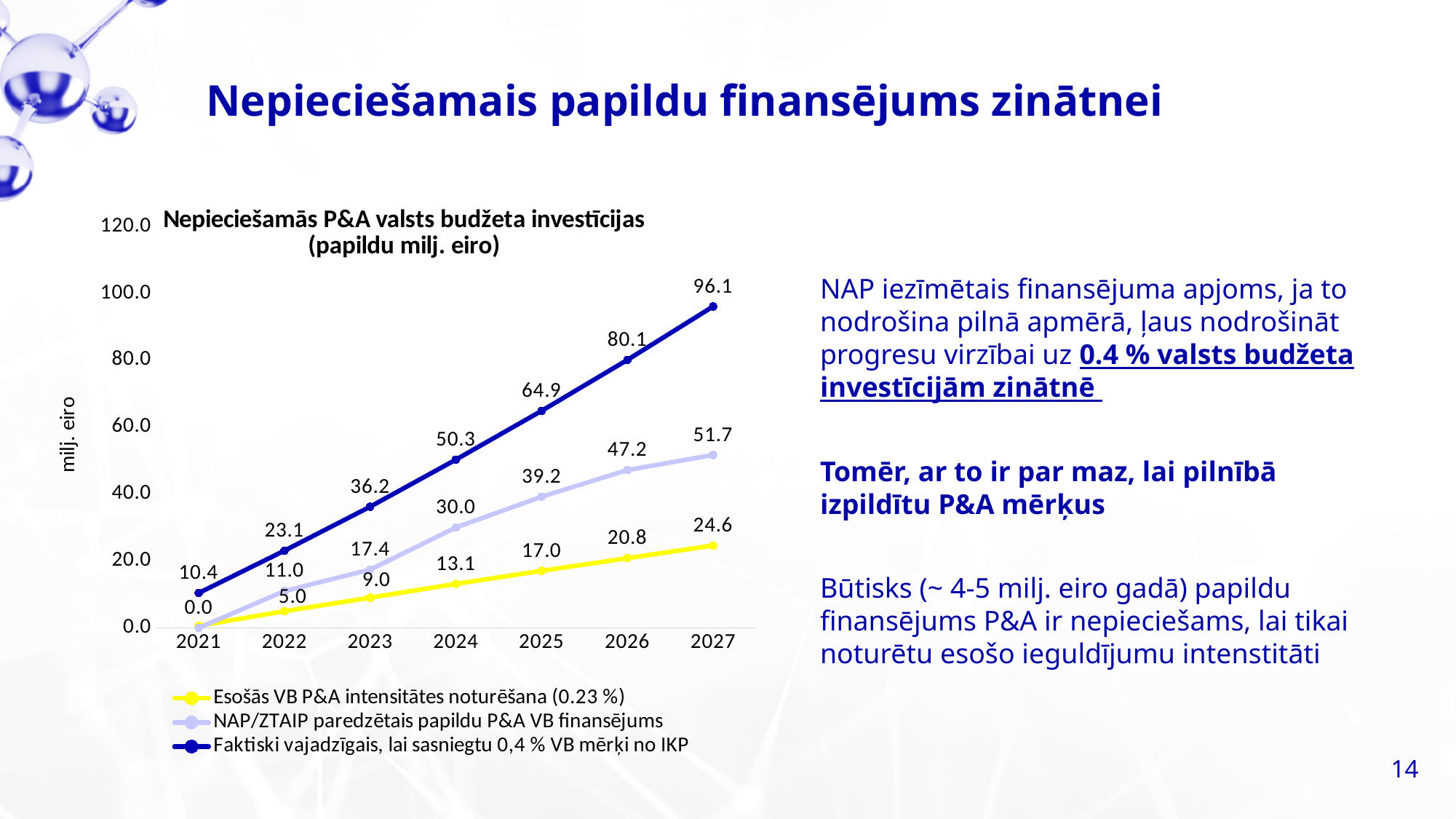
What is the value for 2024 in the series 'NAP/ZTAIP paredzētais papildu P&A VB finansējums'? 30.0 How many years are plotted along the x axis? 7 How many series does the chart legend list? 3 What is the title of the chart? Nepieciešamās P&A valsts budžeta investīcijas (papildu milj. eiro) What is the value for 2027 in the series 'Faktiski vajadzīgais, lai sasniegtu 0,4 % VB mērķi no IKP'? 96.1 What is the difference between the 2027 values of 'Faktiski vajadzīgais, lai sasniegtu 0,4 % VB mērķi no IKP' and 'NAP/ZTAIP paredzētais papildu P&A VB finansējums'? 44.4 What is the value for 2026 in the series 'Esošās VB P&A intensitātes noturēšana (0.23 %)'? 20.8 What type of chart is shown on the slide? line chart Which series has the larger value in 2025: 'NAP/ZTAIP paredzētais papildu P&A VB finansējums' or 'Esošās VB P&A intensitātes noturēšana (0.23 %)'? NAP/ZTAIP paredzētais papildu P&A VB finansējums Do the values of the series 'Esošās VB P&A intensitātes noturēšana (0.23 %)' rise or fall from 2021 to 2027? rise In which year does the series 'Faktiski vajadzīgais, lai sasniegtu 0,4 % VB mērķi no IKP' reach its highest value? 2027 Is the 2026 value of 'Faktiski vajadzīgais, lai sasniegtu 0,4 % VB mērķi no IKP' greater or less than 60.0? greater